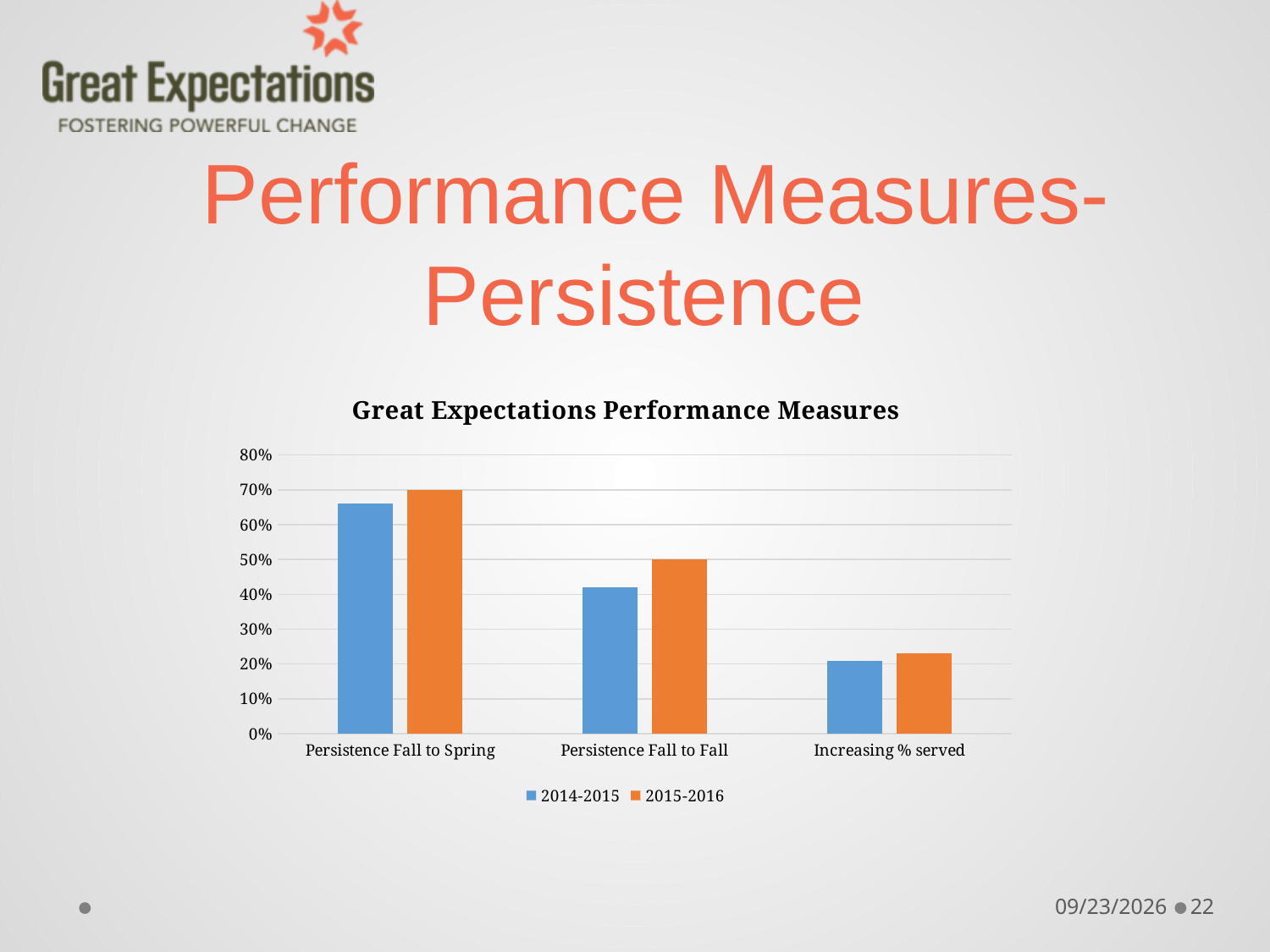
How many series does the legend list? 2 For Persistence Fall to Fall, which series has the larger value, 2014-2015 or 2015-2016? 2015-2016 What is the title of the chart? Great Expectations Performance Measures Is the 2014-2015 value for Persistence Fall to Spring greater or less than 60%? greater What is the 2015-2016 value for Persistence Fall to Fall? 50% How many categories are shown on the x axis? 3 What type of chart is shown on the slide? bar chart Is the 2014-2015 value for Increasing % served greater or less than 30%? less Which category has the lowest 2014-2015 value? Increasing % served What is the 2015-2016 value for Persistence Fall to Spring? 70% Which category has the highest 2015-2016 value? Persistence Fall to Spring Is the 2014-2015 value for Persistence Fall to Fall greater or less than 50%? less